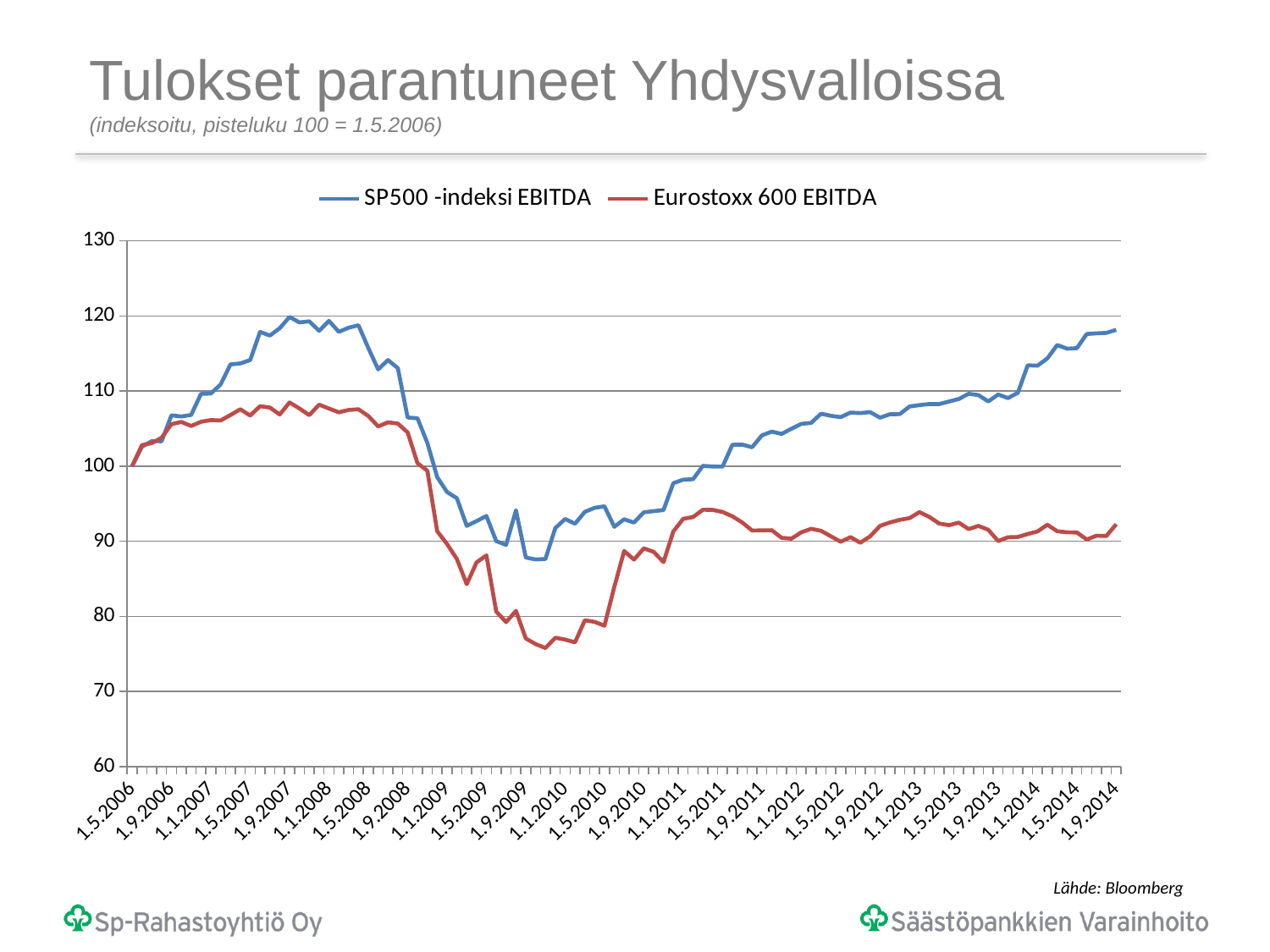
Is the value of SP500 -indeksi EBITDA at 1.9.2014 greater or less than 110? greater Does the SP500 -indeksi EBITDA line rise or fall between 1.1.2012 and 1.9.2014? rise Is the value of Eurostoxx 600 EBITDA at 1.9.2014 greater or less than 100? less What are the two series named in the legend? SP500 -indeksi EBITDA and Eurostoxx 600 EBITDA What is the source given for the chart? Bloomberg Does the Eurostoxx 600 EBITDA line rise or fall between 1.5.2008 and 1.9.2009? fall What kind of chart is shown on the slide? Line chart At 1.9.2014, which series has the higher value, SP500 -indeksi EBITDA or Eurostoxx 600 EBITDA? SP500 -indeksi EBITDA Is the value of SP500 -indeksi EBITDA at 1.9.2007 greater or less than 110? greater How many series does the legend list? 2 What is the value of both series at 1.5.2006, the index base date? 100